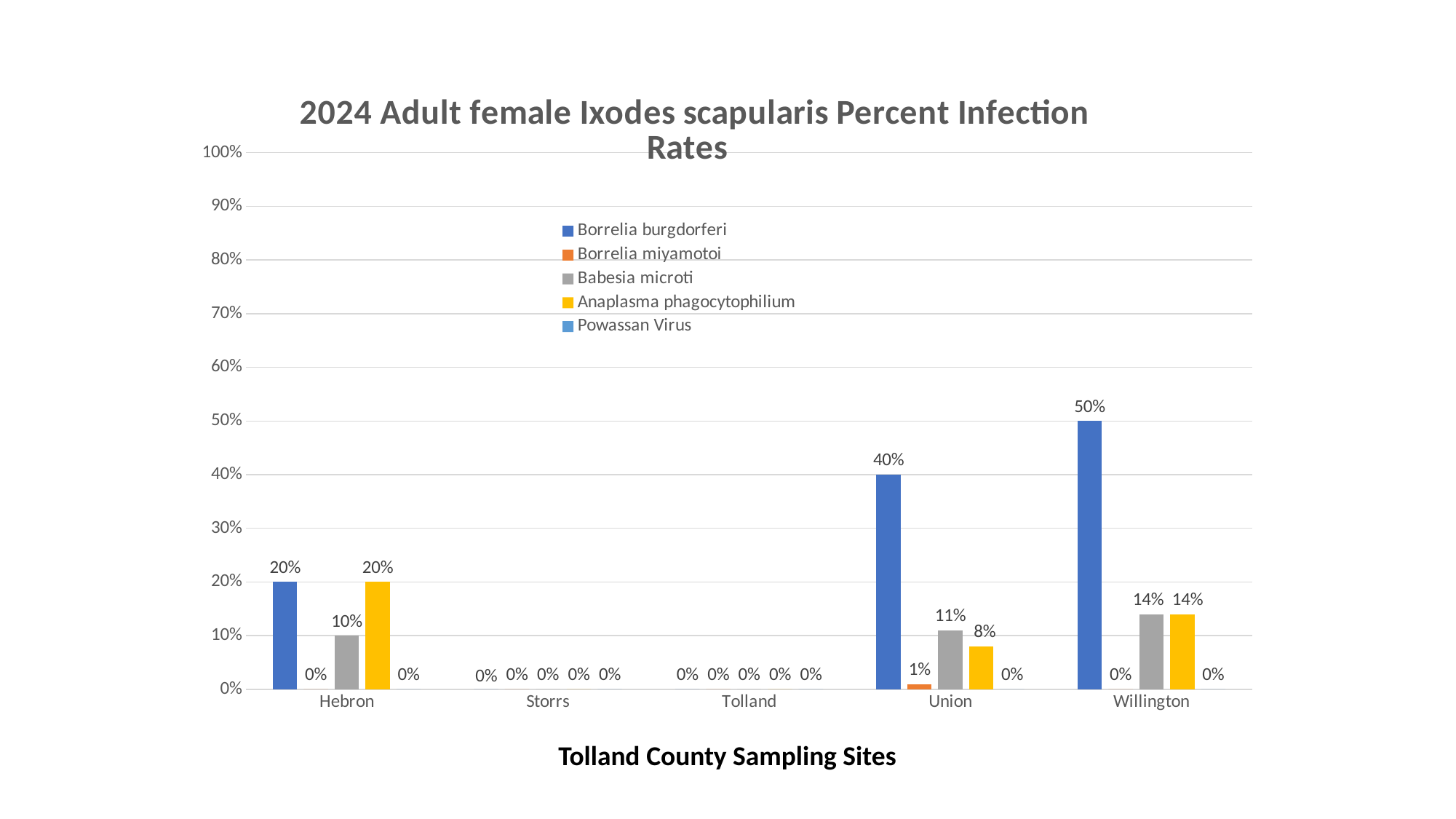
What is the title of the chart? 2024 Adult female Ixodes scapularis Percent Infection Rates Which sampling site has the highest Borrelia burgdorferi infection rate? Willington What kind of chart is shown on the slide? Bar chart What is the Borrelia burgdorferi infection rate at Willington? 50% What is the Borrelia miyamotoi infection rate at Union? 1% How many sampling sites are shown on the x axis? 5 How many series does the legend list? 5 What is the Powassan Virus infection rate at Willington? 0% Which is larger, the Anaplasma phagocytophilium rate at Union or at Willington? Willington What is the Babesia microti infection rate at Union? 11% What is the difference between the Borrelia burgdorferi infection rates at Willington and Union? 10% What is the Anaplasma phagocytophilium infection rate at Hebron? 20%